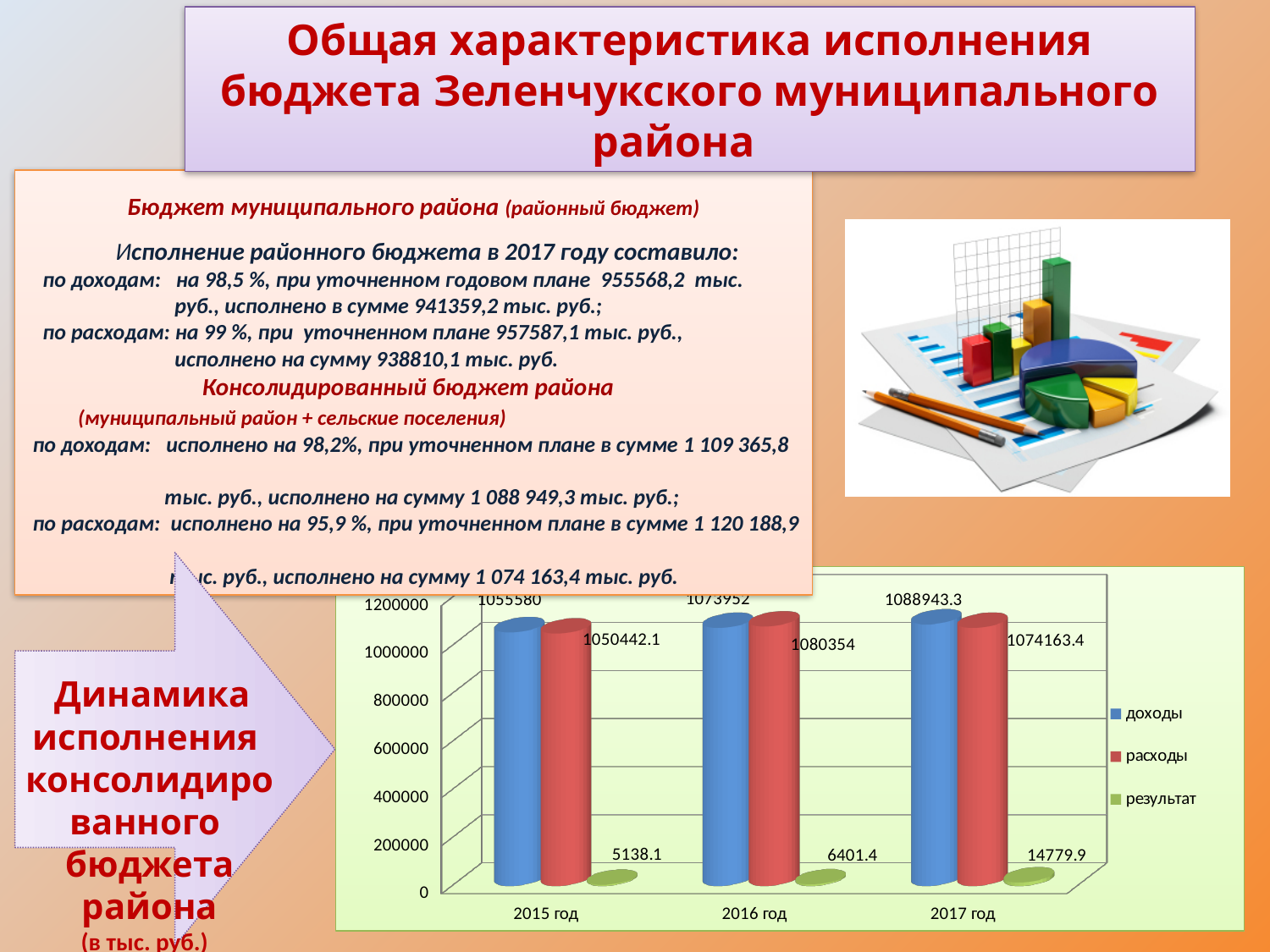
Does the результат value rise or fall from 2015 год to 2017 год in the bar chart? rise How many years are shown on the x axis of the bar chart? 3 How many series does the legend of the bar chart list? 3 Which year has the lowest результат value in the bar chart? 2015 год What is the difference between доходы and расходы for 2017 год in the bar chart? 14779.9 Is the value of расходы for 2015 год greater or less than 1000000 in the bar chart? greater What is the value of доходы for 2017 год in the bar chart? 1088943.3 What is the value of расходы for 2016 год in the bar chart? 1080354 What is the value of результат for 2017 год in the bar chart? 14779.9 Which year has the highest результат value in the bar chart? 2017 год What kind of chart is shown at the bottom of the slide? bar chart What is the value of доходы for 2015 год in the bar chart? 1055580